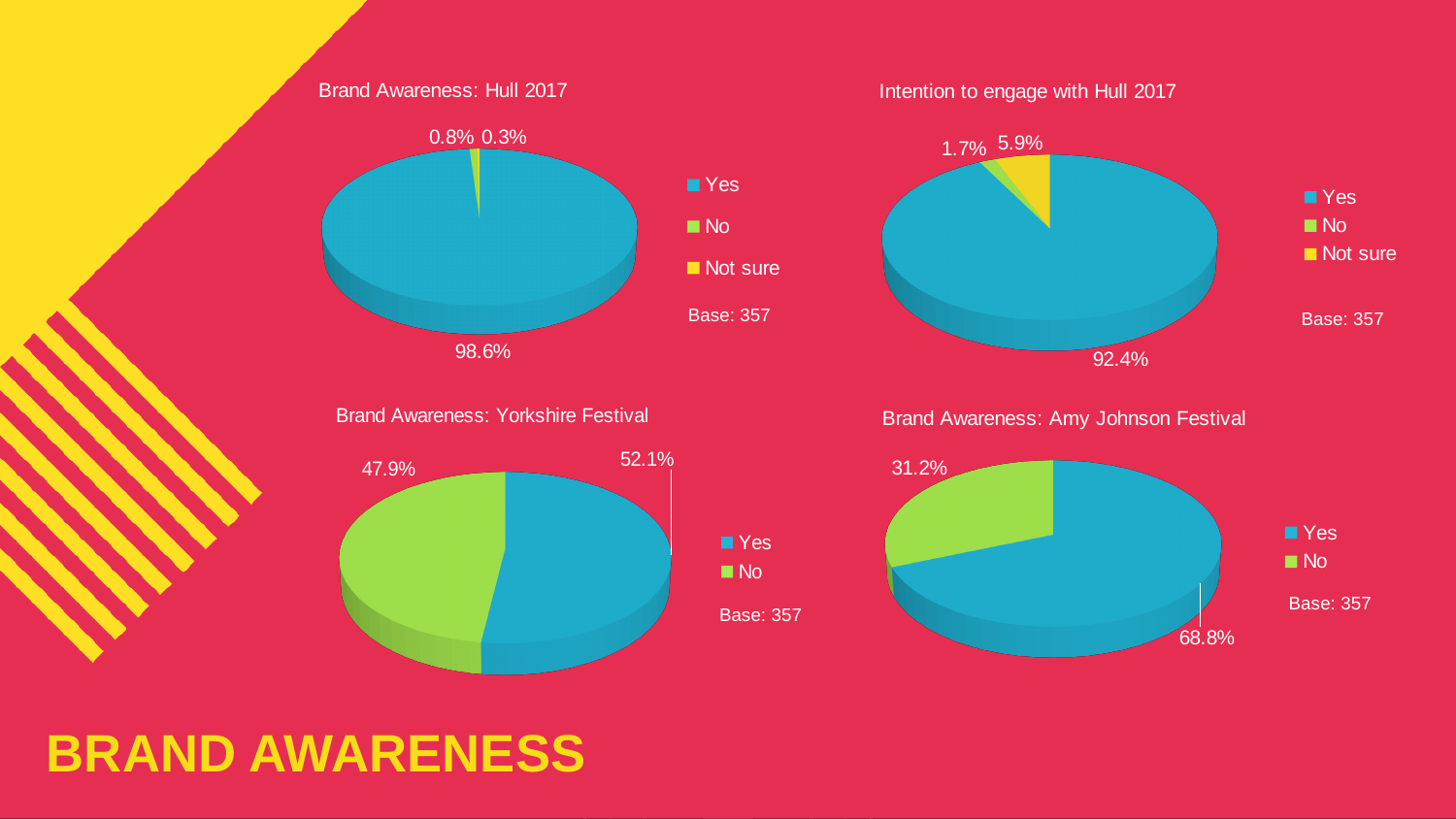
In the 'Brand Awareness: Amy Johnson Festival' chart, what share of respondents answered Yes? 68.8% In the 'Brand Awareness: Hull 2017' chart, what share of respondents answered Yes? 98.6% In the 'Brand Awareness: Hull 2017' chart, what share of respondents answered Not sure? 0.3% In the 'Intention to engage with Hull 2017' chart, what share of respondents answered Not sure? 5.9% In the 'Brand Awareness: Yorkshire Festival' chart, what is the difference between the Yes and No shares? 4.2% In the 'Brand Awareness: Yorkshire Festival' chart, what share of respondents answered No? 47.9% In the 'Brand Awareness: Amy Johnson Festival' chart, which response has the larger share, Yes or No? Yes What kind of chart is used for 'Brand Awareness: Hull 2017'? Pie chart How many categories does the legend of the 'Intention to engage with Hull 2017' chart list? 3 How many slices does the 'Brand Awareness: Amy Johnson Festival' pie chart have? 2 What base size is shown next to the 'Brand Awareness: Yorkshire Festival' chart? Base: 357 In the 'Intention to engage with Hull 2017' chart, which response has the smallest share? No